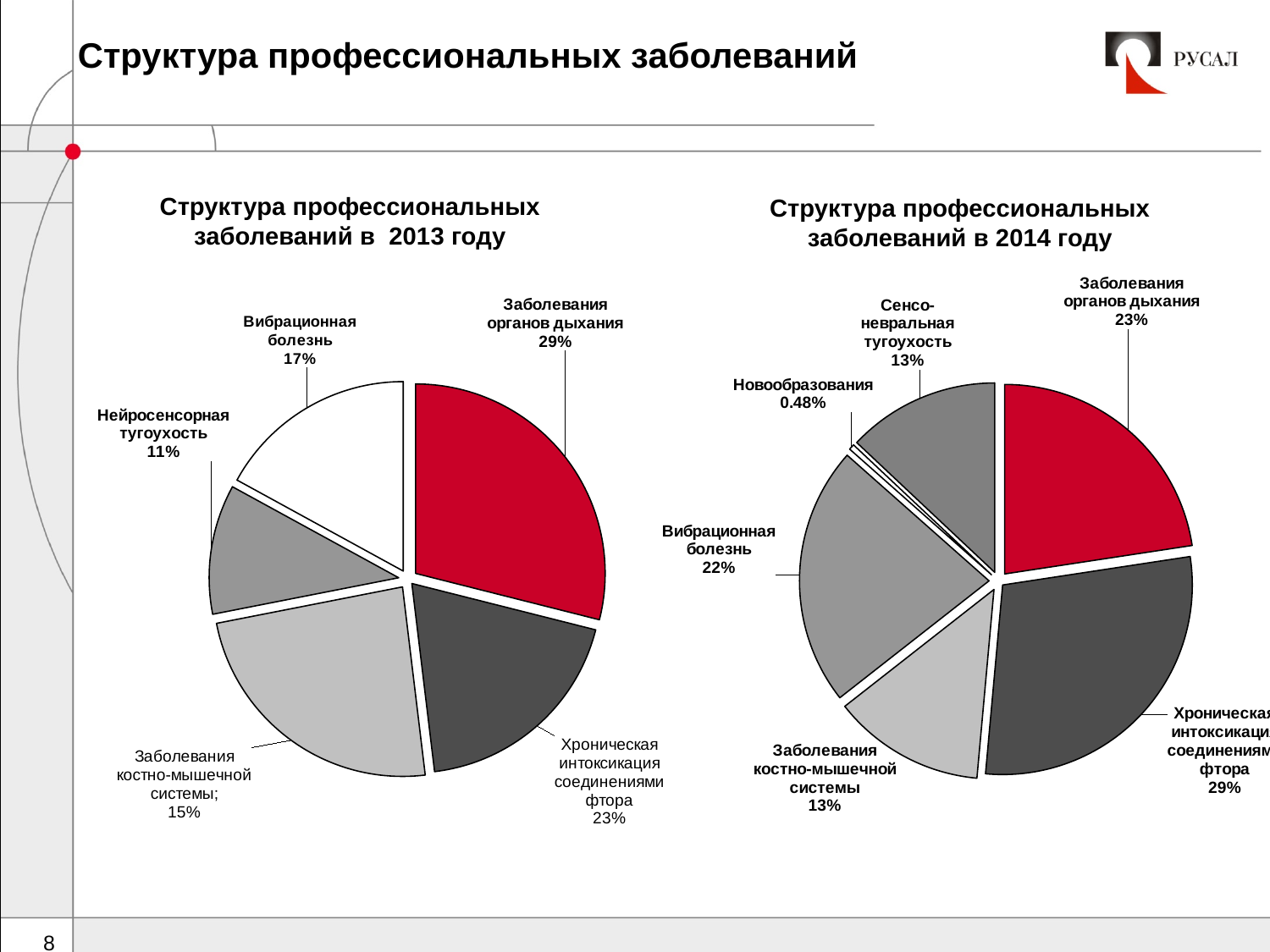
What type of chart is used on the left side of the slide for 2013? Pie chart In the 2014 chart, which is larger: Вибрационная болезнь or Сенсоневральная тугоухость? Вибрационная болезнь In the 2014 chart, which category has the largest share? Хроническая интоксикация соединениями фтора In the 2013 chart, what is the difference between the shares of Заболевания органов дыхания and Заболевания костно-мышечной системы? 14% In the 2014 chart, what share is Вибрационная болезнь? 22% How many categories does the 2014 chart show? 6 In the 2013 chart, which category has the smallest share? Нейросенсорная тугоухость In the 2014 chart, which category has the smallest share? Новообразования In the 2013 chart, what share is Вибрационная болезнь? 17% In the 2013 chart, which category has the largest share? Заболевания органов дыхания In the 2013 chart (Структура профессиональных заболеваний в 2013 году), what share is Заболевания органов дыхания? 29% In the 2014 chart (Структура профессиональных заболеваний в 2014 году), what share is Новообразования? 0.48%